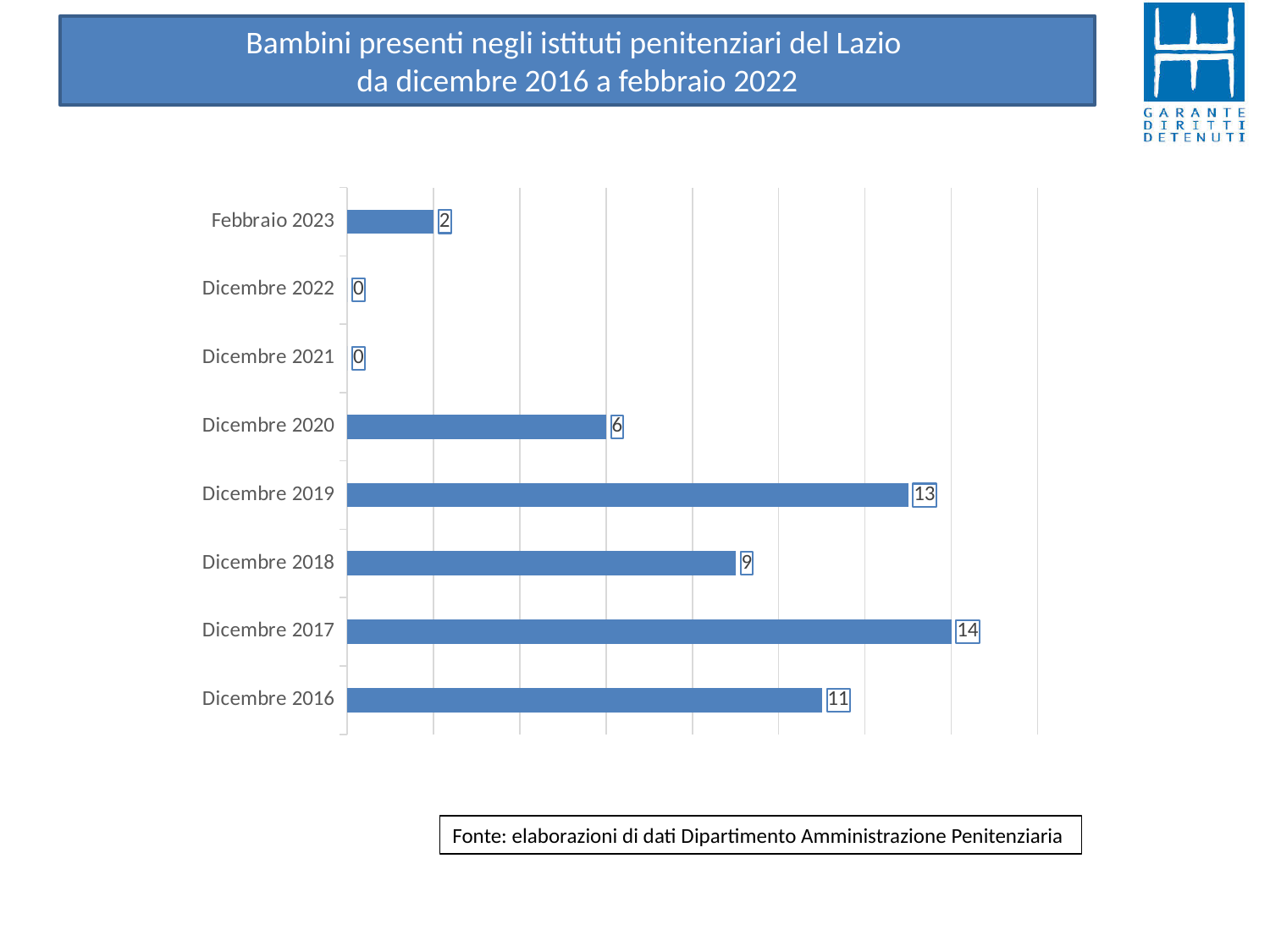
Which is larger, the value for Dicembre 2016 or the value for Dicembre 2018? Dicembre 2016 What is the value for Dicembre 2016? 11 Which category has the highest value? Dicembre 2017 What kind of chart is shown on the slide? Bar chart How many categories have a value of 0? 2 What is the title of the slide? Bambini presenti negli istituti penitenziari del Lazio da dicembre 2016 a febbraio 2022 What is the value for Dicembre 2019? 13 What is the difference between the values for Dicembre 2019 and Dicembre 2020? 7 How many categories are shown on the chart? 8 What is the value for Dicembre 2020? 6 What is the value for Febbraio 2023? 2 What is the difference between the values for Dicembre 2017 and Dicembre 2018? 5